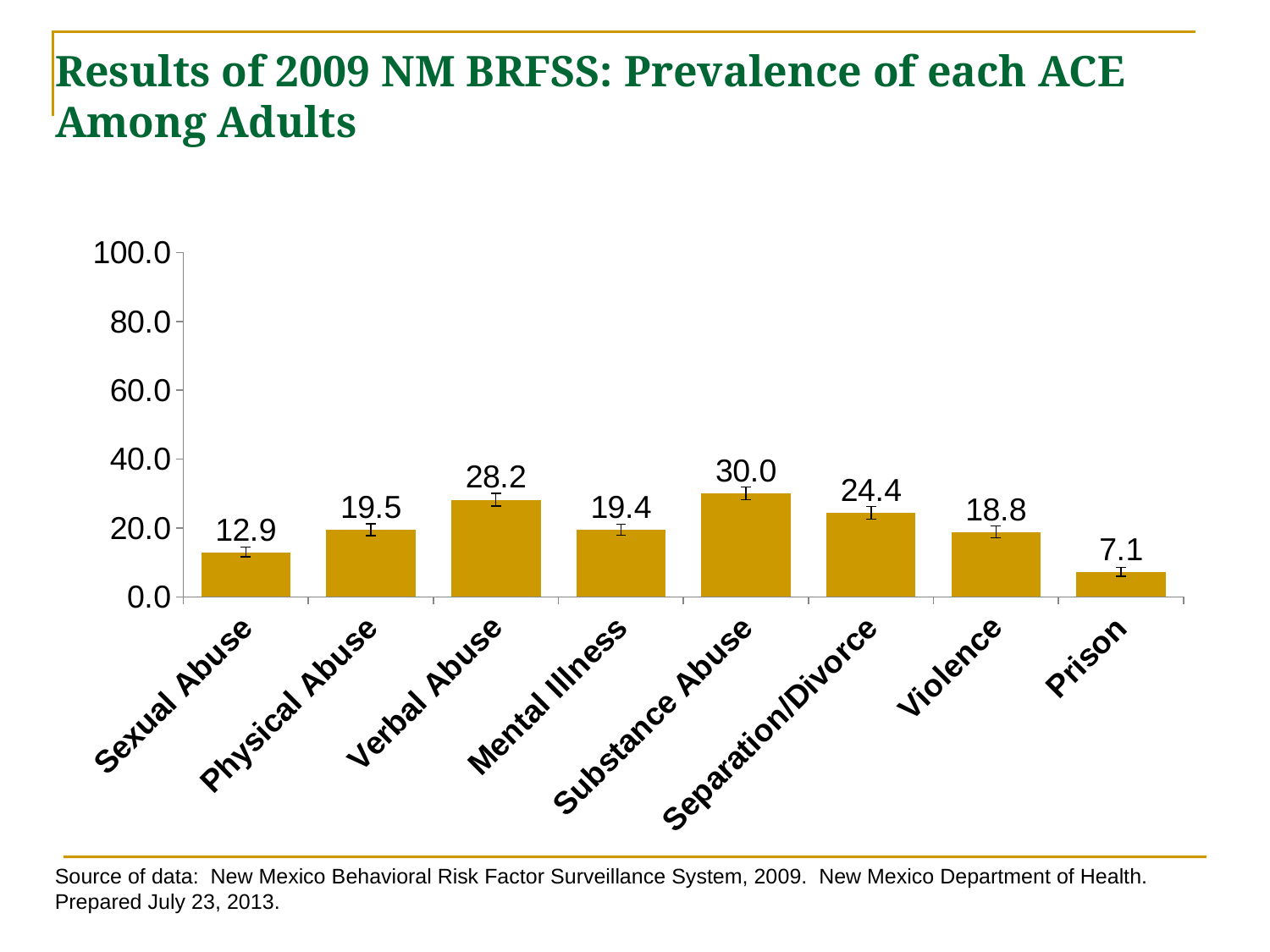
What is the difference between the values for Substance Abuse and Sexual Abuse? 17.1 Which category has the highest value? Substance Abuse How many categories are shown on the x axis? 8 Which category has the lowest value? Prison What is the value for Prison? 7.1 What is the value for Verbal Abuse? 28.2 What is the highest tick value shown on the y axis? 100.0 What kind of chart is shown on the slide? bar chart What is the value for Separation/Divorce? 24.4 Is the value for Verbal Abuse greater or less than 20.0? greater What is the difference between the values for Verbal Abuse and Mental Illness? 8.8 Which is larger, the value for Physical Abuse or the value for Violence? Physical Abuse